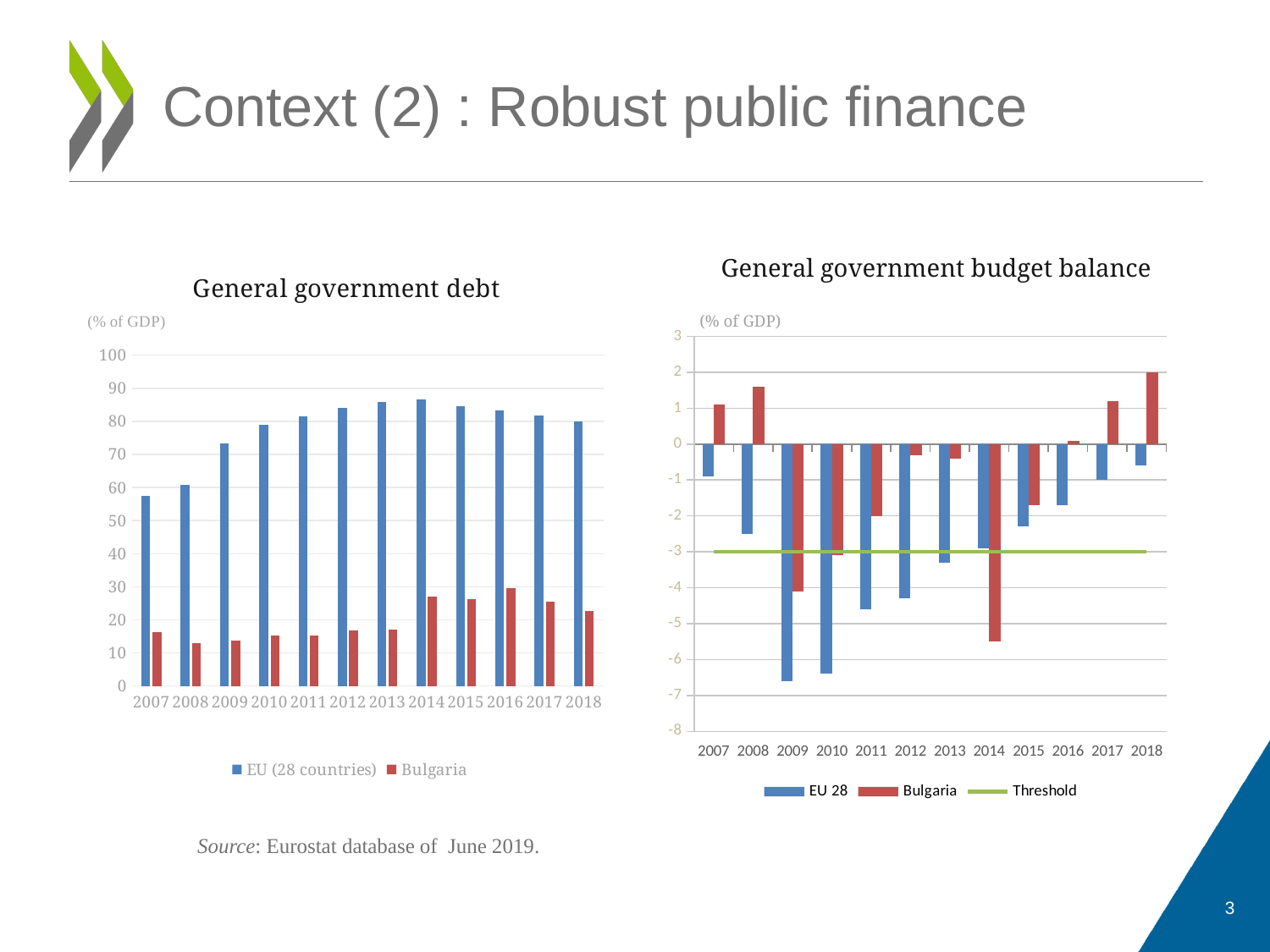
In the General government budget balance chart, which year has the highest value for Bulgaria? 2018 In the General government debt chart, how many years are shown on the x axis? 12 In the General government budget balance chart, which year has the lowest value for Bulgaria? 2014 In the General government debt chart, is the value for EU (28 countries) in 2007 greater or less than 60? less In the General government budget balance chart, how many entries does the legend list? 3 In the General government debt chart, which year has the highest value for Bulgaria? 2016 In the General government budget balance chart, at what value is the Threshold line drawn? -3 In the General government budget balance chart, is the value for EU 28 in 2009 greater or less than -6? less In the General government debt chart, is the value for Bulgaria in 2016 greater or less than 20? greater What kind of chart is the General government debt chart? bar chart In the General government debt chart, which is larger in 2014, EU (28 countries) or Bulgaria? EU (28 countries) In the General government debt chart, how many series does the legend list? 2